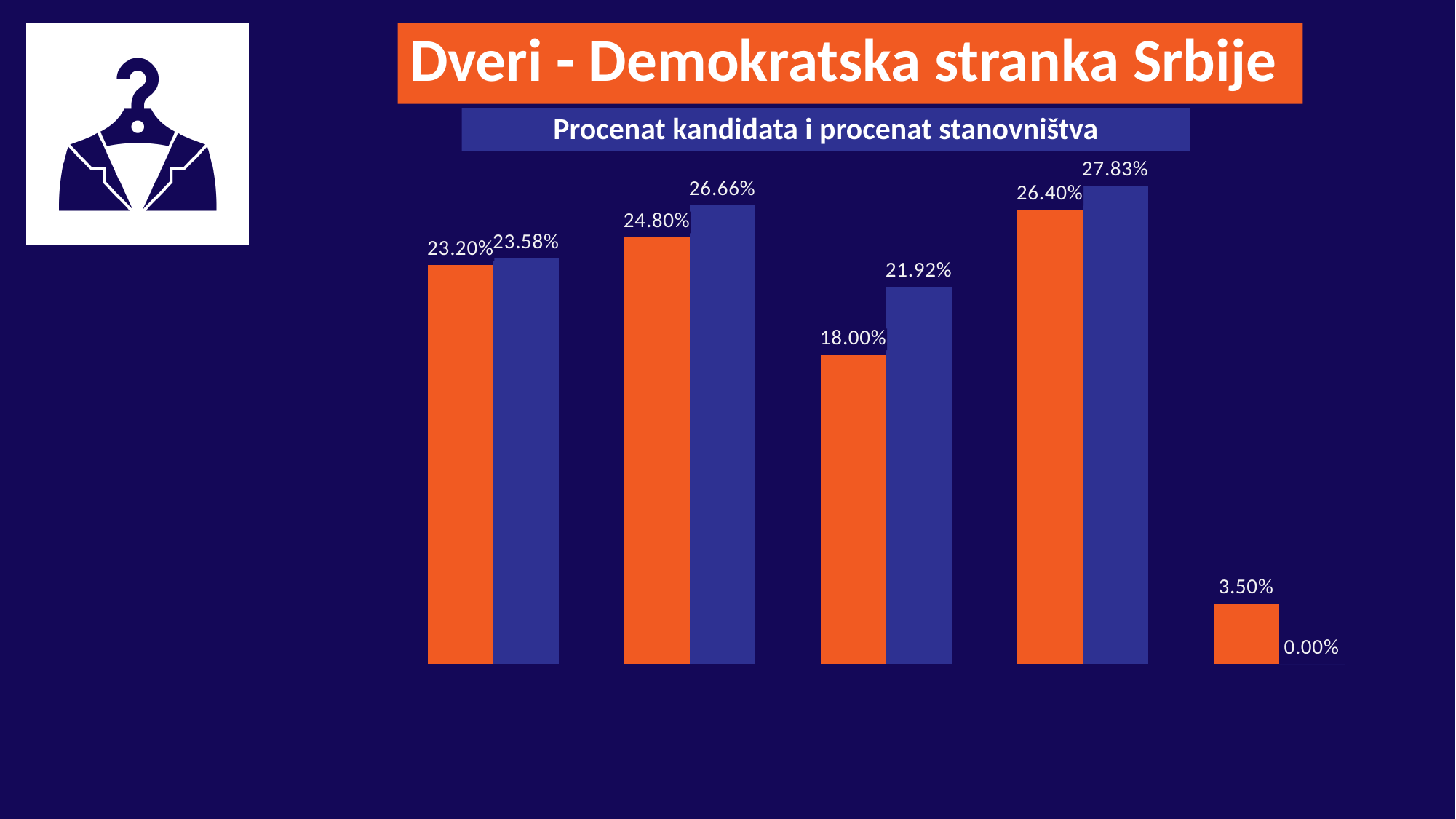
What type of chart is shown on the slide? bar chart Which bar has the highest value in the chart? the blue bar in the fourth group (27.83%) What is the value of the orange bar in the third group from the left? 18.00% What is the value of the blue bar in the second group from the left? 26.66% What is the title of the chart? Procenat kandidata i procenat stanovništva What is the difference between the blue and orange bars in the third group from the left? 3.92% What is the value of the blue bar in the fourth group from the left? 27.83% What is the value of the orange bar in the first (leftmost) group? 23.20% How many groups of bars are plotted in the chart? 5 Which bar has the lowest value in the chart? the blue bar in the fifth group (0.00%) What is the value of the blue bar in the fifth (rightmost) group? 0.00% In the fifth (rightmost) group, which bar is larger, the orange or the blue? orange